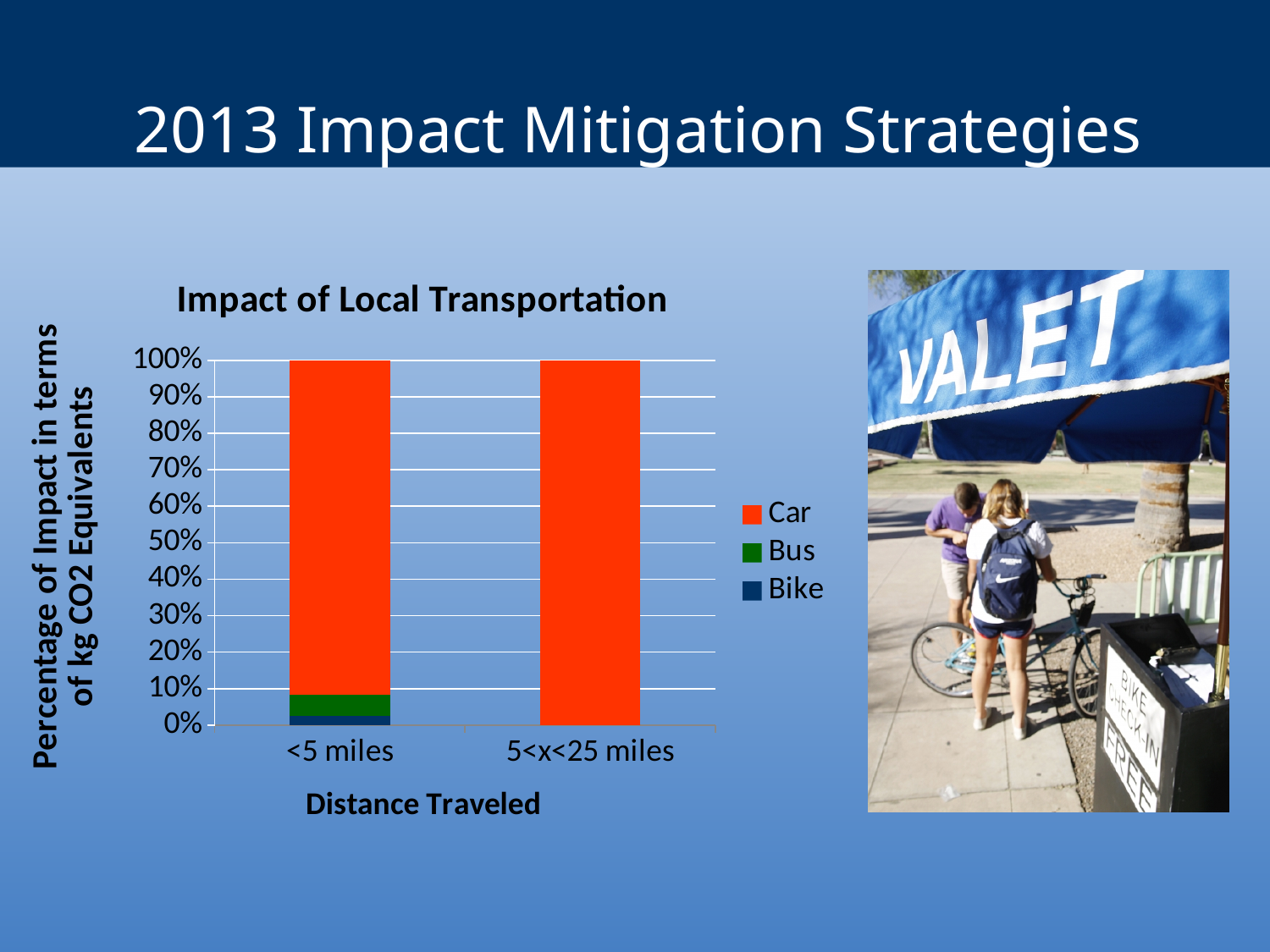
What is the total of the stacked bar for 5<x<25 miles? 100% Which category has the larger Car share, <5 miles or 5<x<25 miles? 5<x<25 miles Is the value for Bus in the <5 miles category greater or less than 10%? less How many series does the chart legend list? 3 What is the label of the x axis? Distance Traveled What is the title of the chart? Impact of Local Transportation Which series has the smallest share in the <5 miles category? Bike Is the value for Car in the <5 miles category greater or less than 80%? greater What kind of chart is shown on the slide? Stacked bar chart How many distance categories are shown on the x axis? 2 What is the value for Car in the 5<x<25 miles category? 100% Which series has the largest share in the <5 miles category? Car